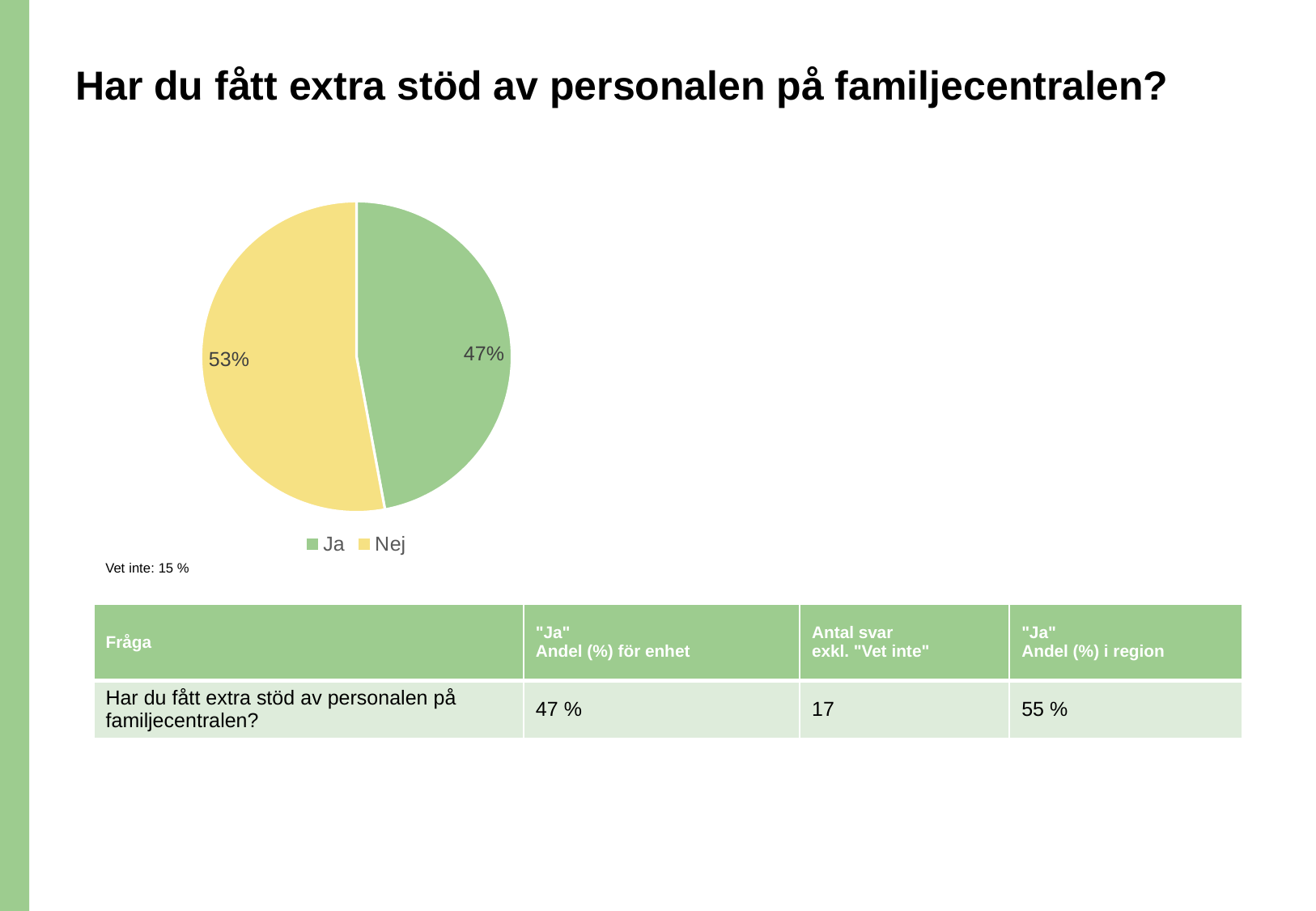
How many entries does the legend list? 2 What share of the pie is labelled "Nej"? 53% Is the "Ja" share of the pie greater or less than 50%? less What colour is the "Nej" slice in the pie chart? yellow Which is larger, the "Ja" slice or the "Nej" slice? Nej What is the difference in percentage points between the "Nej" slice and the "Ja" slice? 6 Which slice of the pie is the largest? Nej What share of the pie is labelled "Ja"? 47% Which slice of the pie is the smallest? Ja What colour is the "Ja" slice in the pie chart? green What kind of chart is shown on the slide? pie chart How many slices does the pie chart have? 2